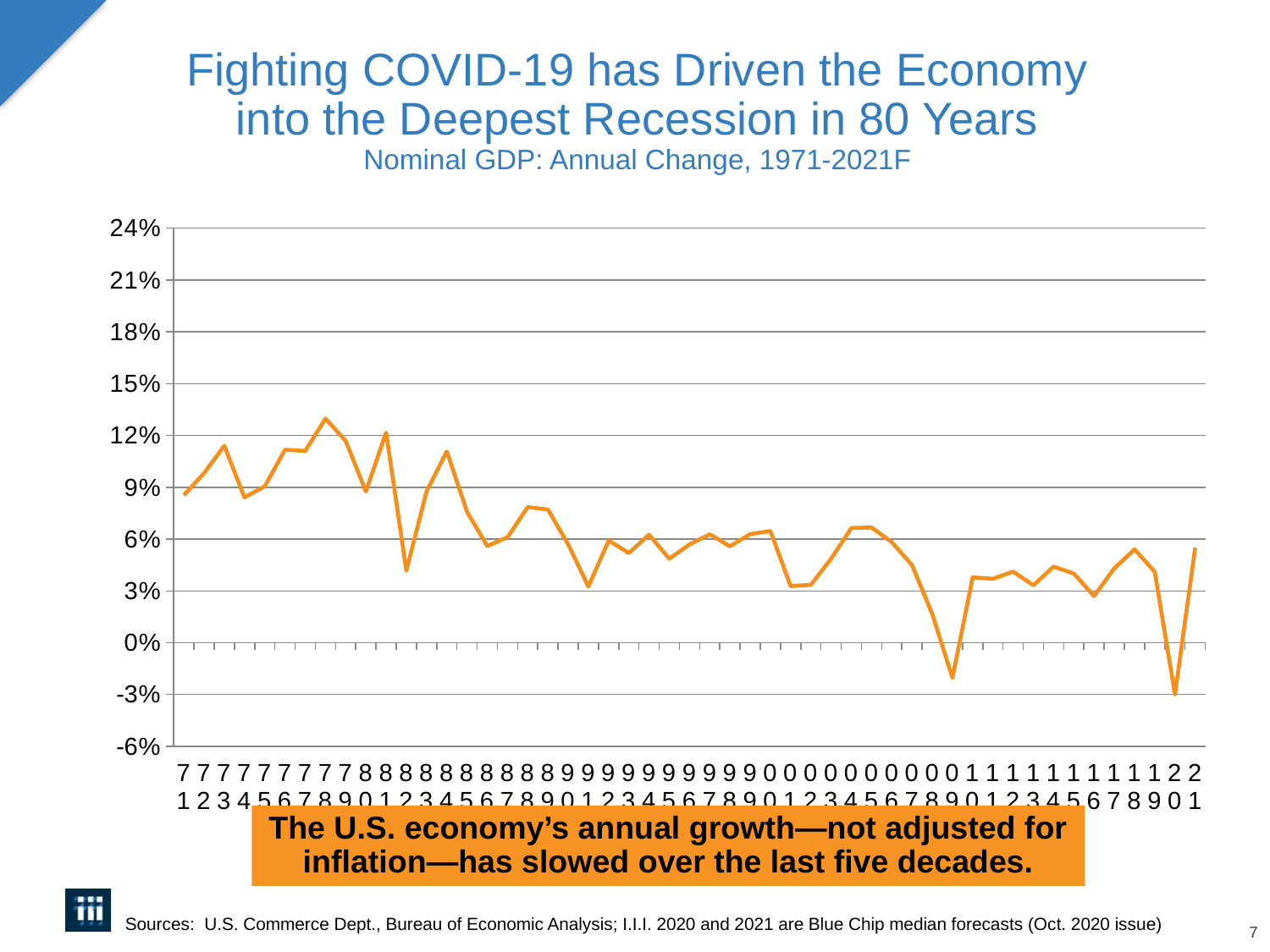
Is the value for 2009 greater or less than 0%? less Is the value for 2021 greater or less than 3%? greater What kind of chart is shown on the slide? line chart Is the value for 1978 greater or less than 12%? greater Over the whole period from 1971 to 2021, does nominal GDP annual growth generally rise or fall? fall Which year has the lowest nominal GDP annual change on the chart? 2020 Which year has the larger nominal GDP annual change, 1971 or 2021? 1971 What is the subtitle describing the data plotted on the chart? Nominal GDP: Annual Change, 1971-2021F Which year has the highest nominal GDP annual change on the chart? 1978 How many years (data points) are plotted on the chart? 51